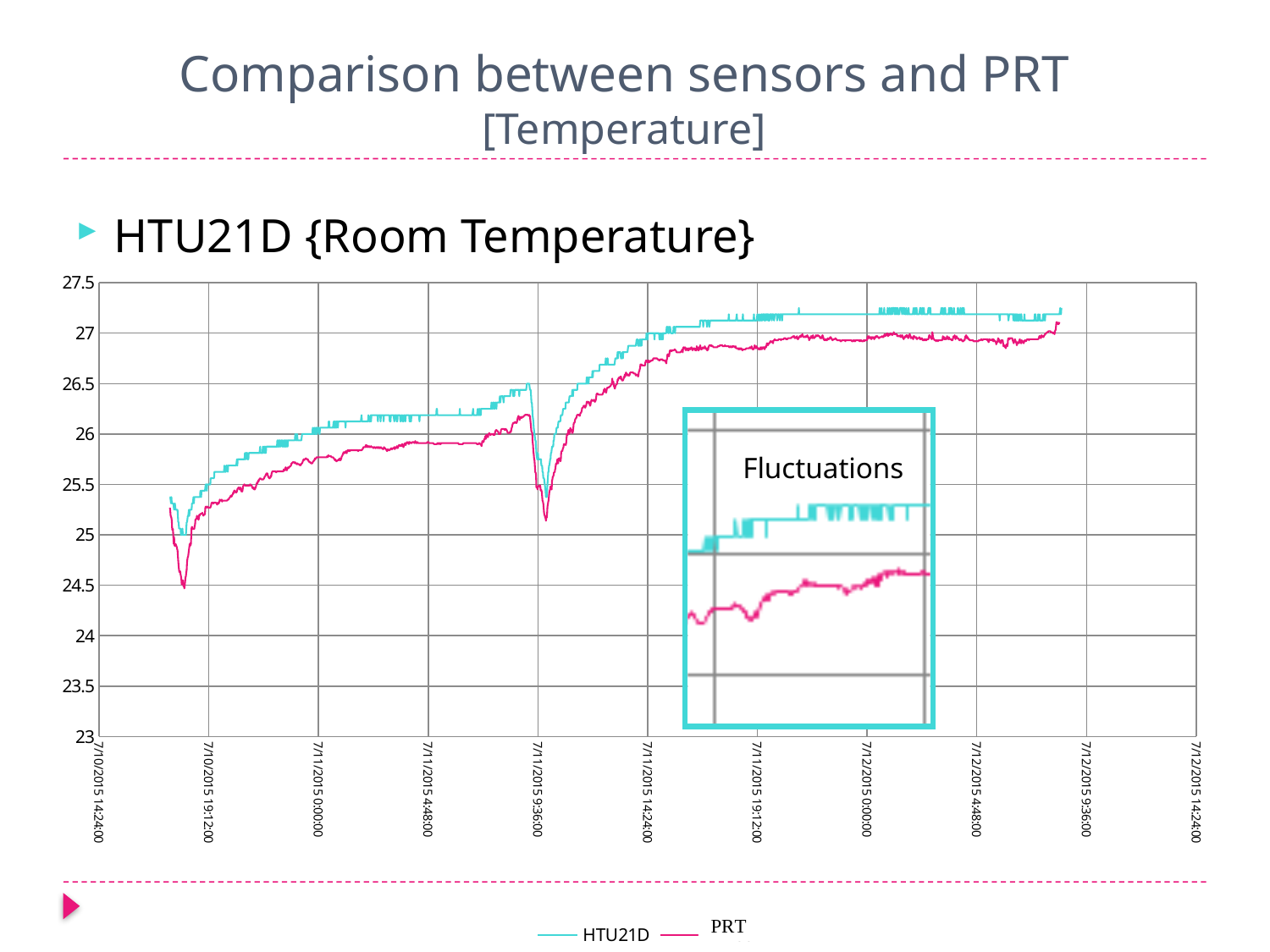
How many series does the chart legend list? 2 Is the lowest value of the PRT series greater or less than 25? less Overall, do the temperature values rise or fall from the start to the end of the x axis? rise Is the value of HTU21D at 7/11/2015 4:48:00 greater or less than 26? greater What are the two series named in the chart legend? HTU21D and PRT How many date-time tick labels are shown along the x axis? 11 Which series is plotted higher for most of the chart, HTU21D or PRT? HTU21D What kind of chart is shown on the slide? line chart What label is written inside the zoomed inset box on the chart? Fluctuations Is the value of HTU21D at 7/12/2015 0:00:00 greater or less than 27? greater At the sharp dip near 7/10/2015 19:12:00, which series reaches the lower value, HTU21D or PRT? PRT